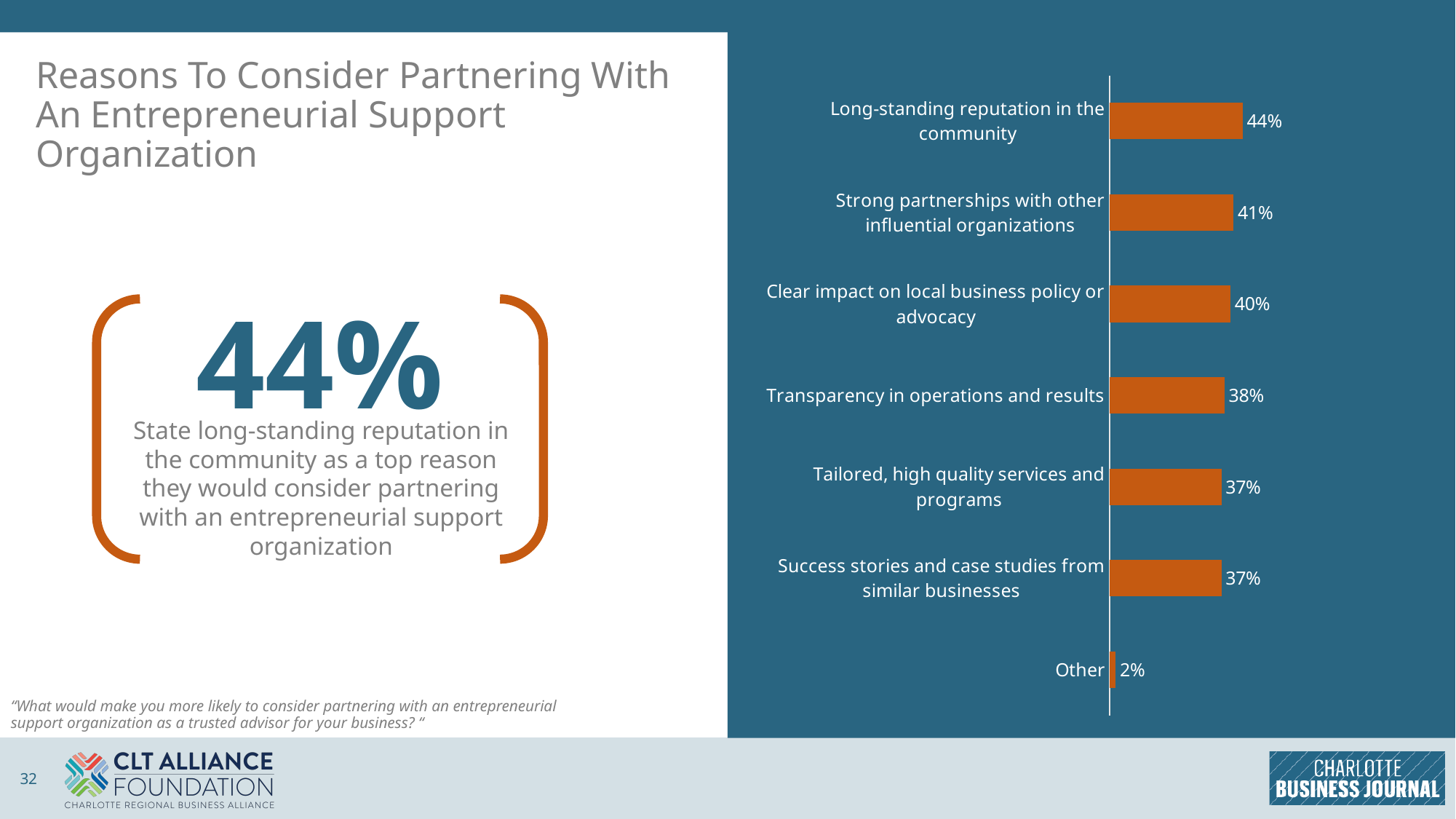
How many categories are shown in the chart? 7 What value is shown for 'Clear impact on local business policy or advocacy'? 40% What percentage is shown for 'Long-standing reputation in the community'? 44% What colour are the bars in the chart? Orange Which category has the highest value in the chart? Long-standing reputation in the community What is the difference between 'Transparency in operations and results' and 'Other'? 36% What value is shown for 'Transparency in operations and results'? 38% Which category has the lowest value in the chart? Other What is the difference between 'Long-standing reputation in the community' and 'Strong partnerships with other influential organizations'? 3% What kind of chart is shown on the slide? Bar chart What percentage is shown for 'Other'? 2% Which is larger: 'Strong partnerships with other influential organizations' or 'Tailored, high quality services and programs'? Strong partnerships with other influential organizations